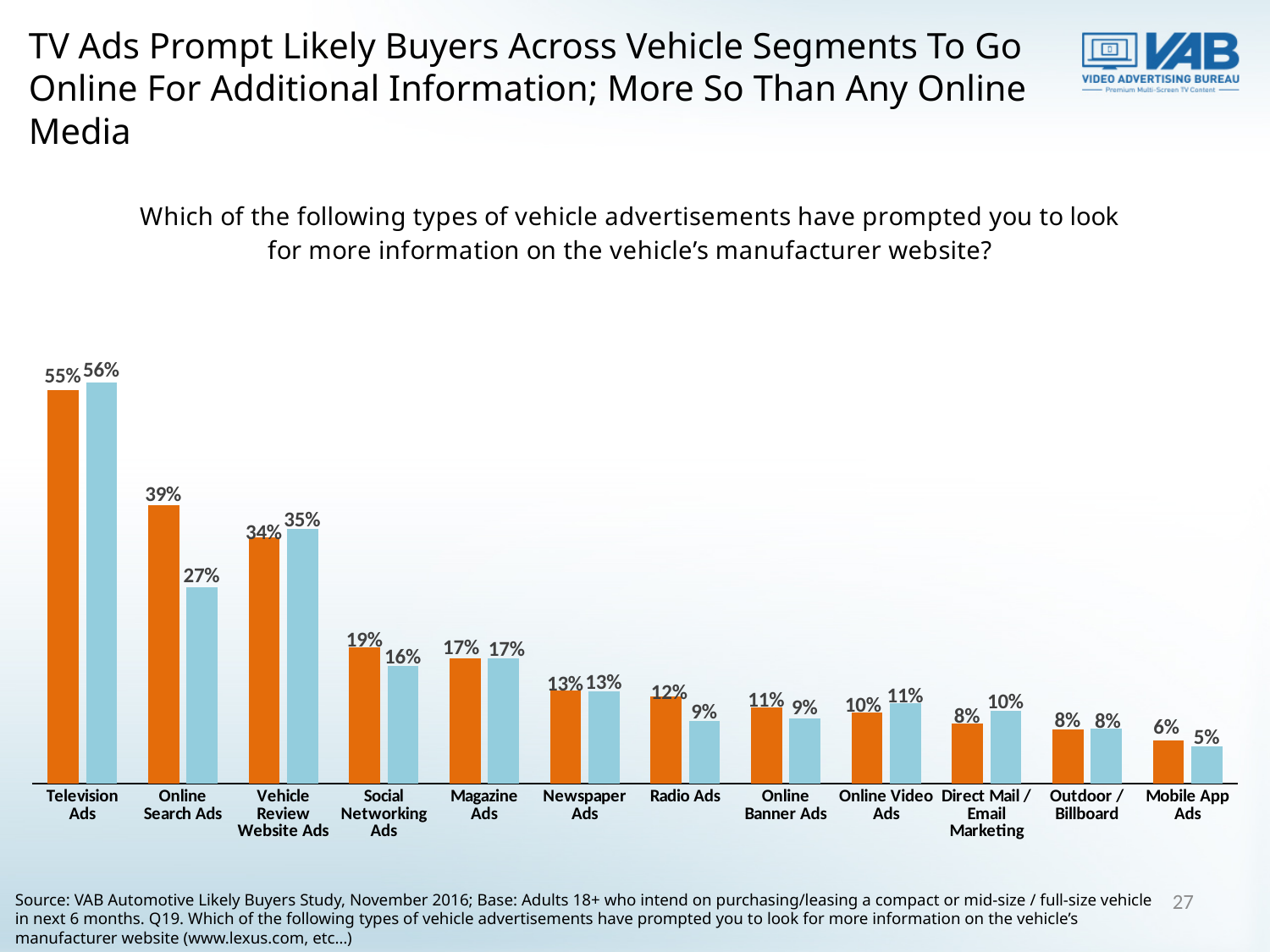
Which category has the highest value for the light blue bars? Television Ads Do the orange bar values generally rise or fall moving from left to right across the x axis? fall What is the value of the light blue bar for Direct Mail / Email Marketing? 10% What is the value of the orange bar for Social Networking Ads? 19% What is the value of the light blue bar for Online Search Ads? 27% Which category has the lowest value for the orange bars? Mobile App Ads What colours are the two bars shown for each category? orange and light blue Which is larger for Radio Ads, the orange bar or the light blue bar? the orange bar How many categories of vehicle advertisements are shown on the x axis? 12 What is the value of the orange bar for Television Ads? 55% What kind of chart is shown on the slide? bar chart What is the difference between the orange and light blue bars for Online Search Ads? 12%